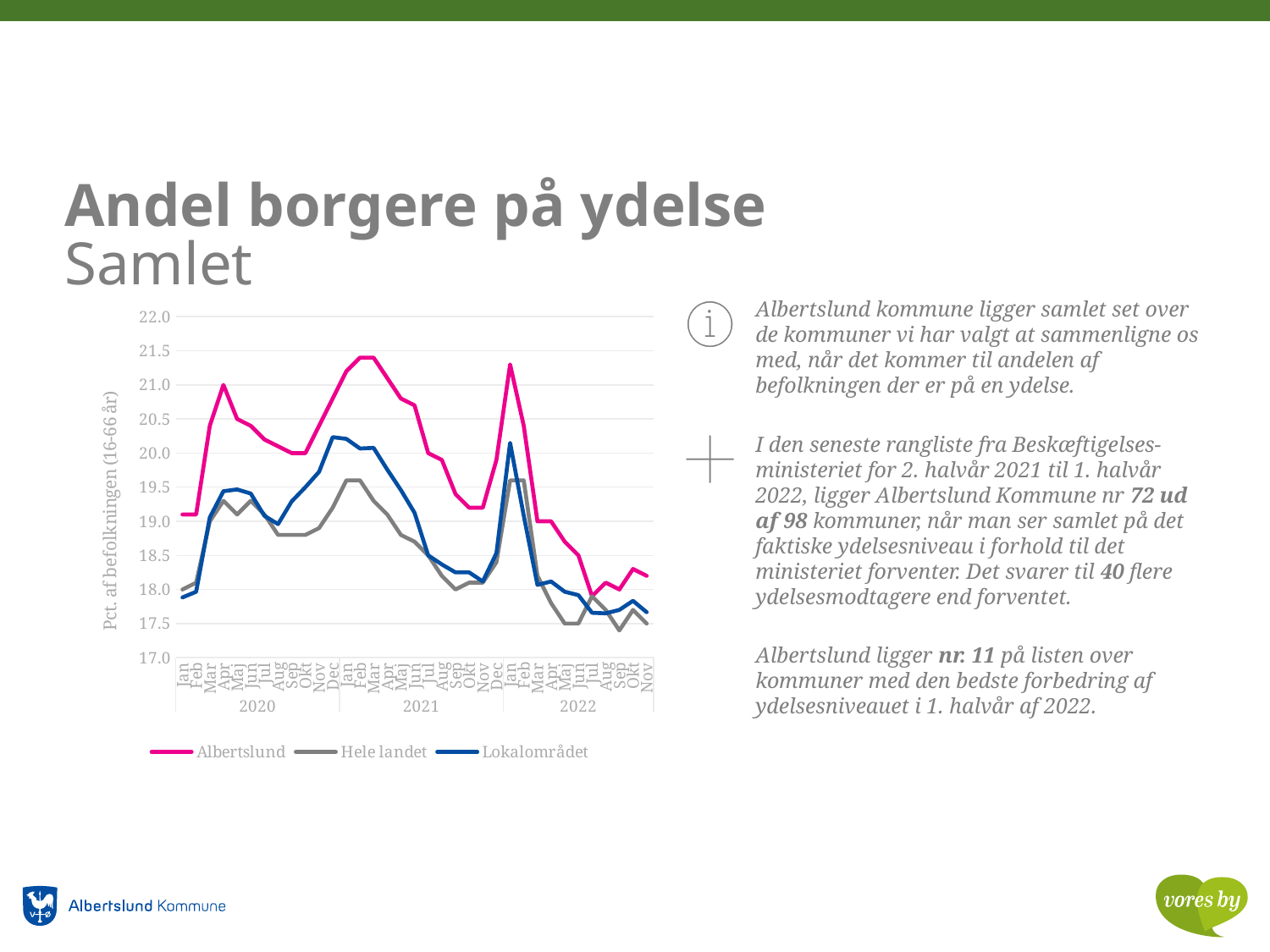
Does the Albertslund line rise or fall from Feb 2021 to Aug 2021? fall Which series are listed in the chart legend? Albertslund, Hele landet, Lokalområdet Is the value for Albertslund in Feb 2021 greater or less than 21.0? greater Which series has the highest value in Mar 2021? Albertslund What kind of chart is shown on the slide? line chart Is the value for Lokalområdet in Dec 2020 greater or less than 20.0? greater What is the label on the vertical axis of the chart? Pct. af befolkningen (16-66 år) Is the value for Hele landet in Jan 2022 greater or less than 19.0? greater How many years are shown along the x axis of the chart? 3 How many series does the chart legend list? 3 Which series has the lowest value in Jul 2022? Lokalområdet